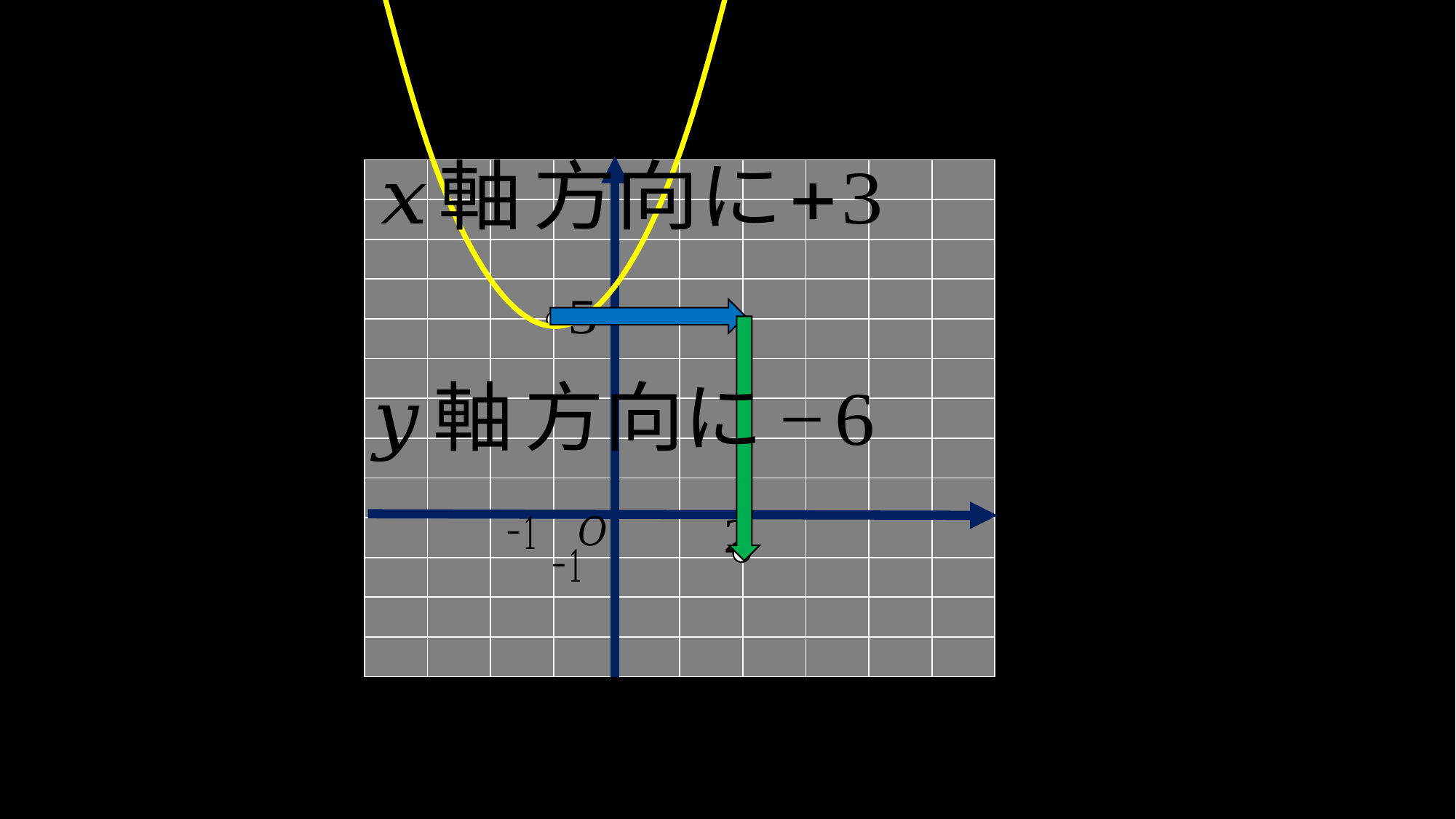
What colour is the arrow showing the shift in the x-axis direction? blue What shift in the y-axis direction is written on the slide? −6 Which shift has the larger magnitude, the x-axis shift or the y-axis shift? the y-axis shift What colour is the arrow showing the shift in the y-axis direction? green Does the yellow parabola open upward or downward? upward What is the difference between the magnitudes of the y-axis shift and the x-axis shift? 3 What shift in the x-axis direction is written on the slide? +3